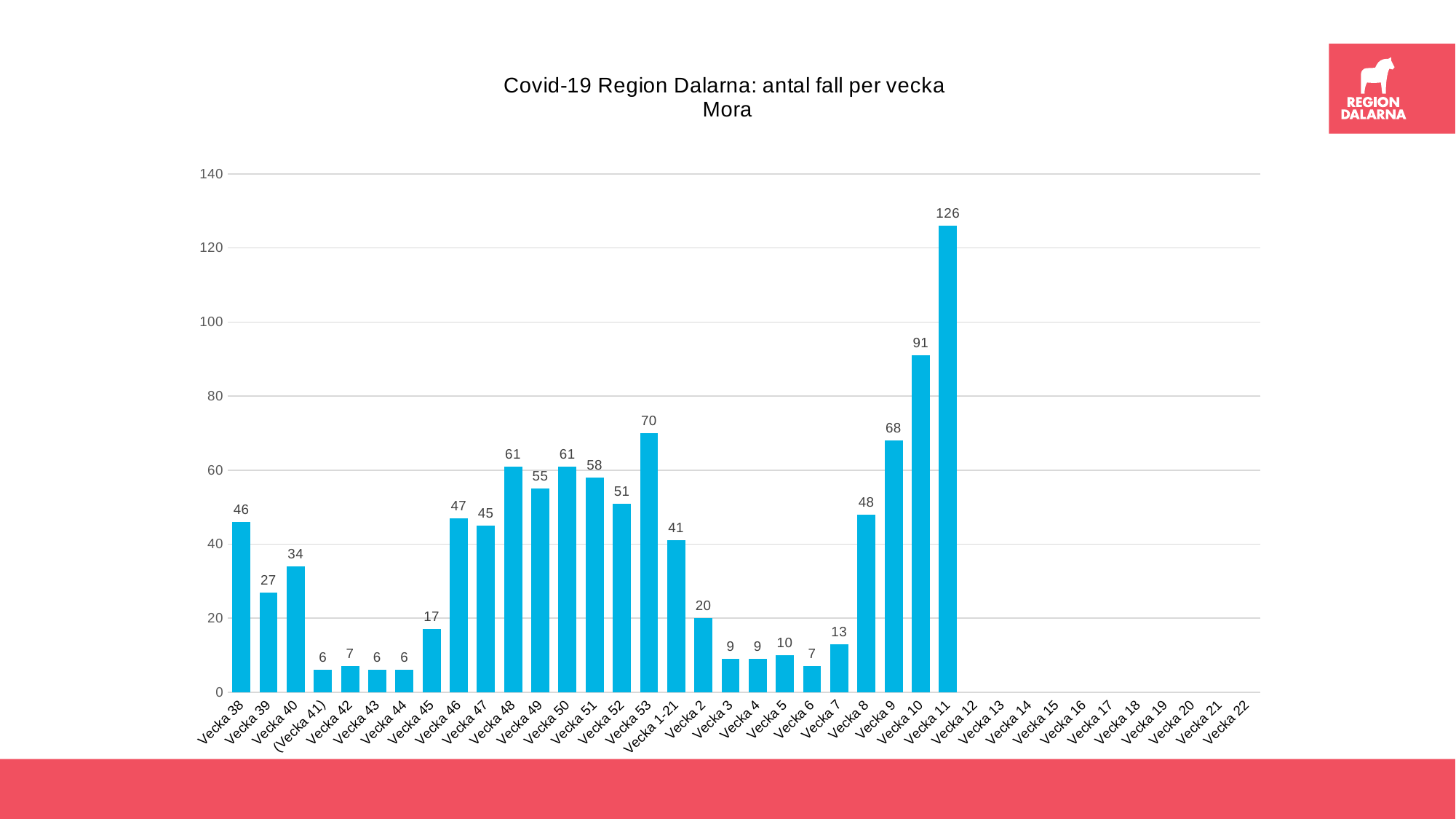
What is the title of the chart? Covid-19 Region Dalarna: antal fall per vecka Mora What is the difference between the values for Vecka 9 and Vecka 8? 20 Which is larger, the value for Vecka 48 or the value for Vecka 49? Vecka 48 What is the value for Vecka 45? 17 What is the value for Vecka 11? 126 How many bars with a value are plotted on the chart? 27 What type of chart is shown on the slide? bar chart What is the difference between the values for Vecka 11 and Vecka 10? 35 What is the value for Vecka 53? 70 Which week has the highest value? Vecka 11 What is the value for Vecka 1-21? 41 Is the value for Vecka 10 greater or less than 80? greater